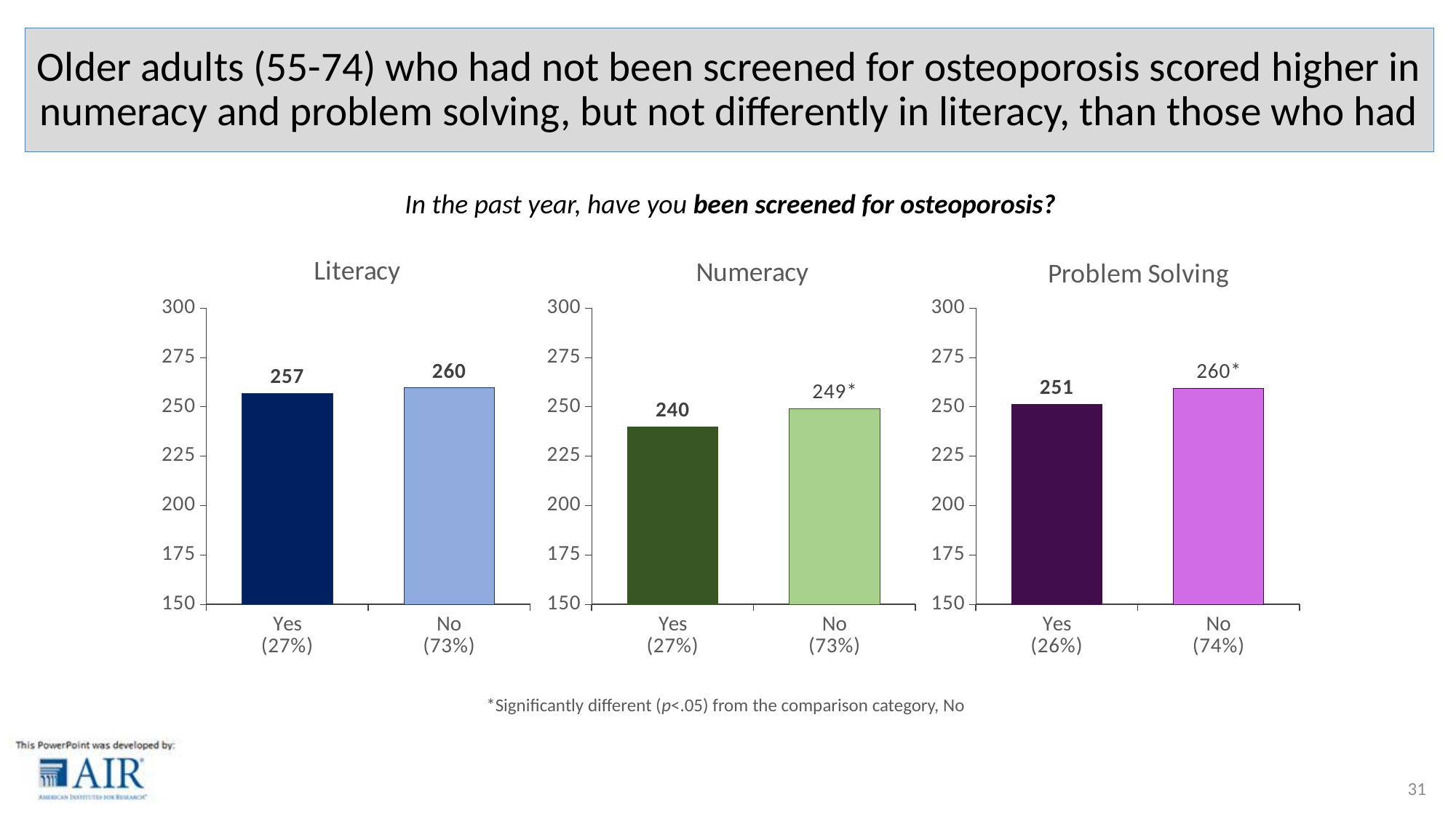
How many bars are in the Literacy chart? 2 In the Numeracy chart, what is the difference between the No and Yes values? 9 In the Numeracy chart, which category has the lowest value? Yes (27%) In the Problem Solving chart, which is larger, the value for Yes or the value for No? No What type of chart is the Numeracy chart? Bar chart In the Literacy chart, what is the value for No (73%)? 260 In the Numeracy chart, what is the value for No (73%)? 249 In the Numeracy chart, what is the value for Yes (27%)? 240 In the Problem Solving chart, what is the value for Yes (26%)? 251 In the Problem Solving chart, what is the difference between the No and Yes values? 9 In the Literacy chart, what is the value for Yes (27%)? 257 In the Problem Solving chart, what is the value for No (74%)? 260